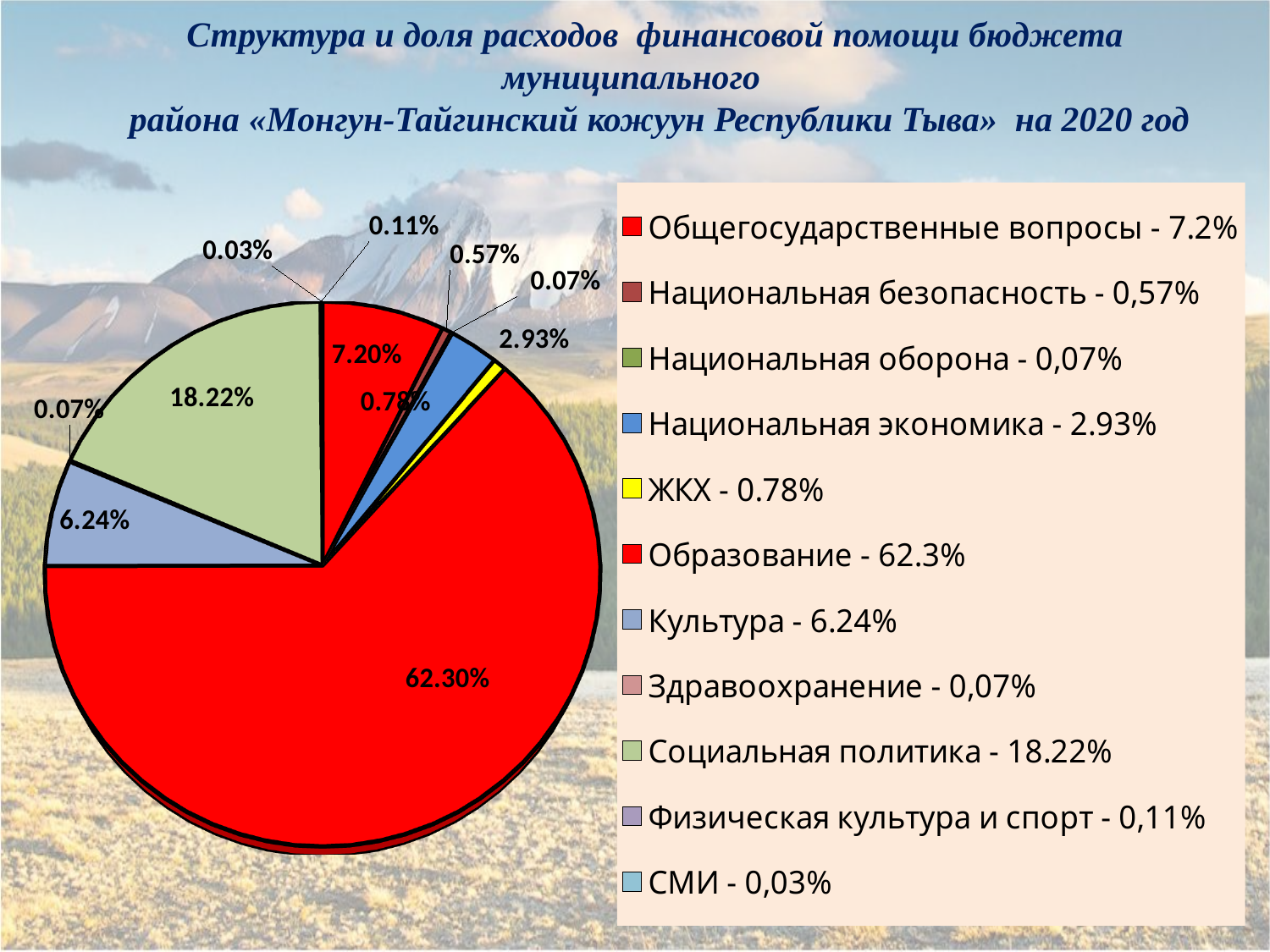
What data label is shown on the Социальная политика slice? 18.22% What data label is shown on the Национальная экономика slice? 2.93% What is the combined share of Образование (62.30%) and Социальная политика (18.22%)? 80.52% What data label is shown on the Образование slice? 62.30% What colour is the Образование slice of the pie? red How many categories does the legend of the pie chart list? 11 Which category has the largest share of the pie? Образование What data label is shown on the Культура slice? 6.24% Which category has the smallest share of the pie? СМИ What kind of chart is shown on the slide? pie chart What is the difference between the Образование share (62.30%) and the Социальная политика share (18.22%)? 44.08% Which has a larger share: Социальная политика or Культура? Социальная политика